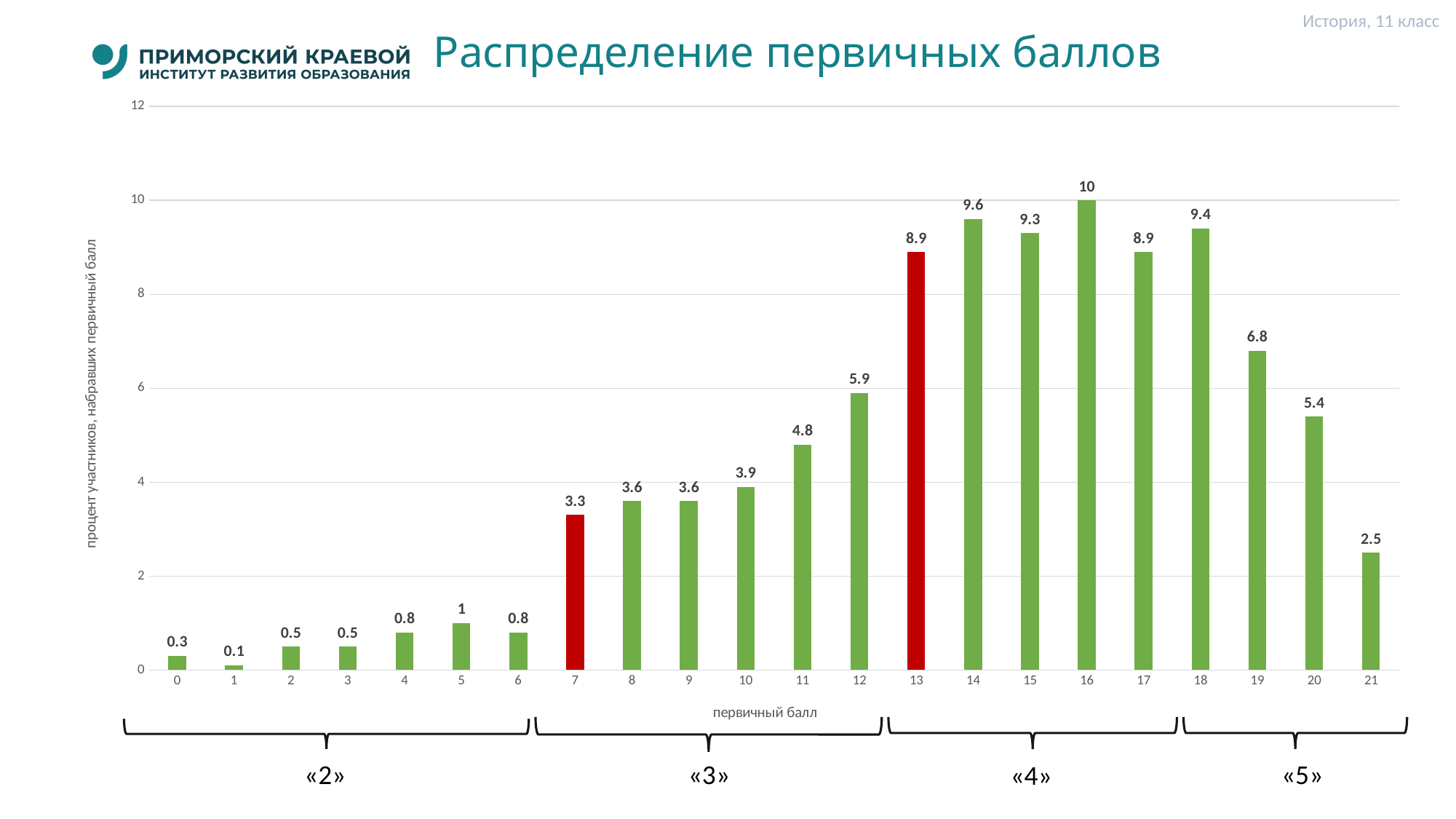
What is the value for primary score 12? 5.9 Which primary score has the highest percentage of participants? 16 What is the difference between the values for primary scores 14 and 13? 0.7 Is the value for primary score 19 greater or less than 6? greater Which primary score has the lowest percentage of participants? 1 Which primary scores are shown with red bars? 7 and 13 Which is larger, the value for primary score 18 or for primary score 15? 18 What is the value for primary score 16? 10 Do the values rise or fall from primary score 16 to primary score 21? fall What kind of chart is shown on the slide? bar chart What is the value for primary score 7? 3.3 How many primary score categories are shown on the x axis? 22